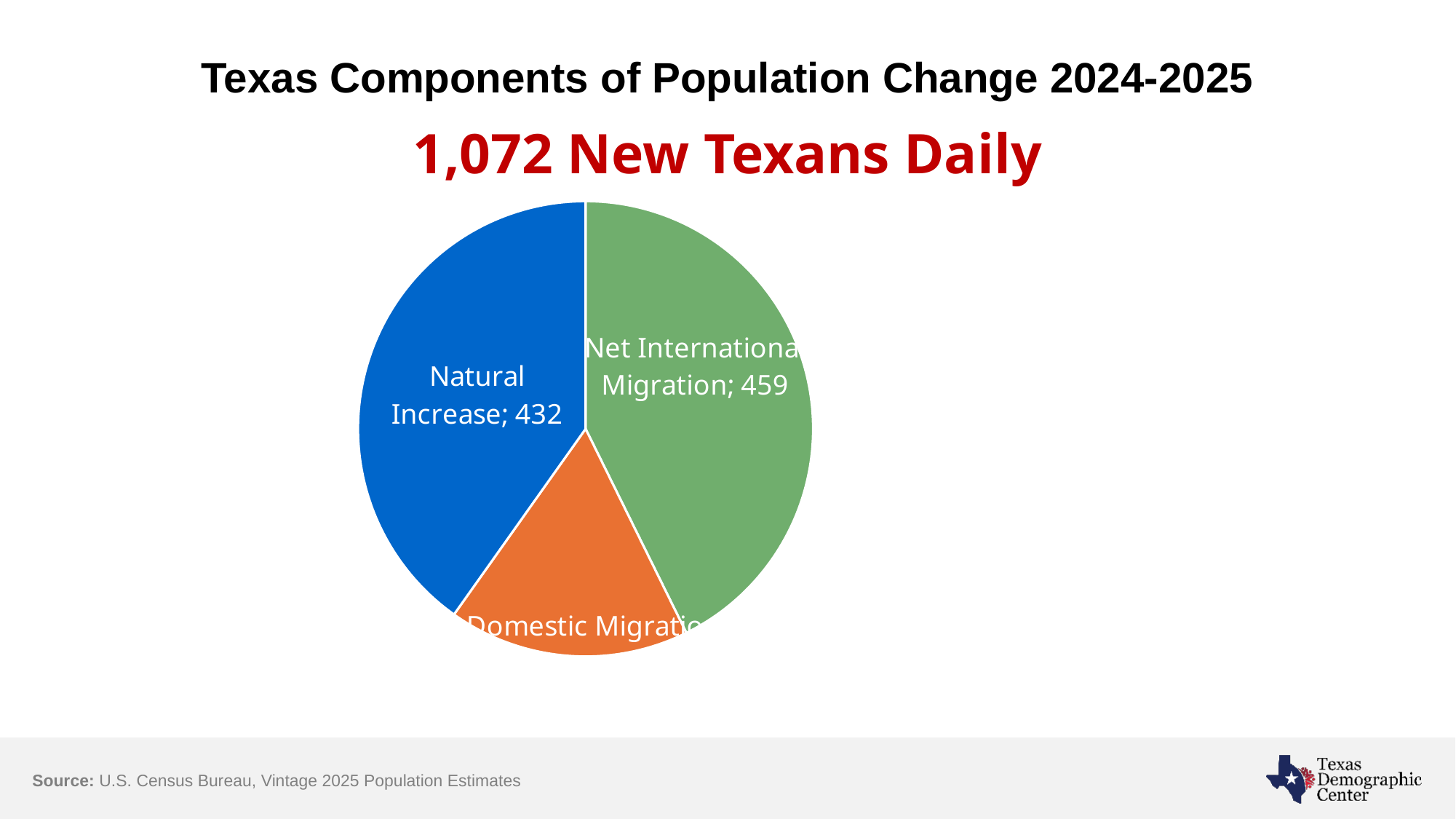
Which component has the largest slice of the pie? Net International Migration How many slices does the pie chart have? 3 What is the value for Natural Increase? 432 What is the total number of new Texans daily shown on the slide? 1,072 Which component has the smallest slice of the pie? Domestic Migration What is the difference between Net International Migration and Natural Increase? 27 What is the title of the chart? Texas Components of Population Change 2024-2025 What kind of chart is shown on the slide? pie chart Which is larger, Natural Increase or Net International Migration? Net International Migration What colour is the Natural Increase slice? blue What is the value for Net International Migration? 459